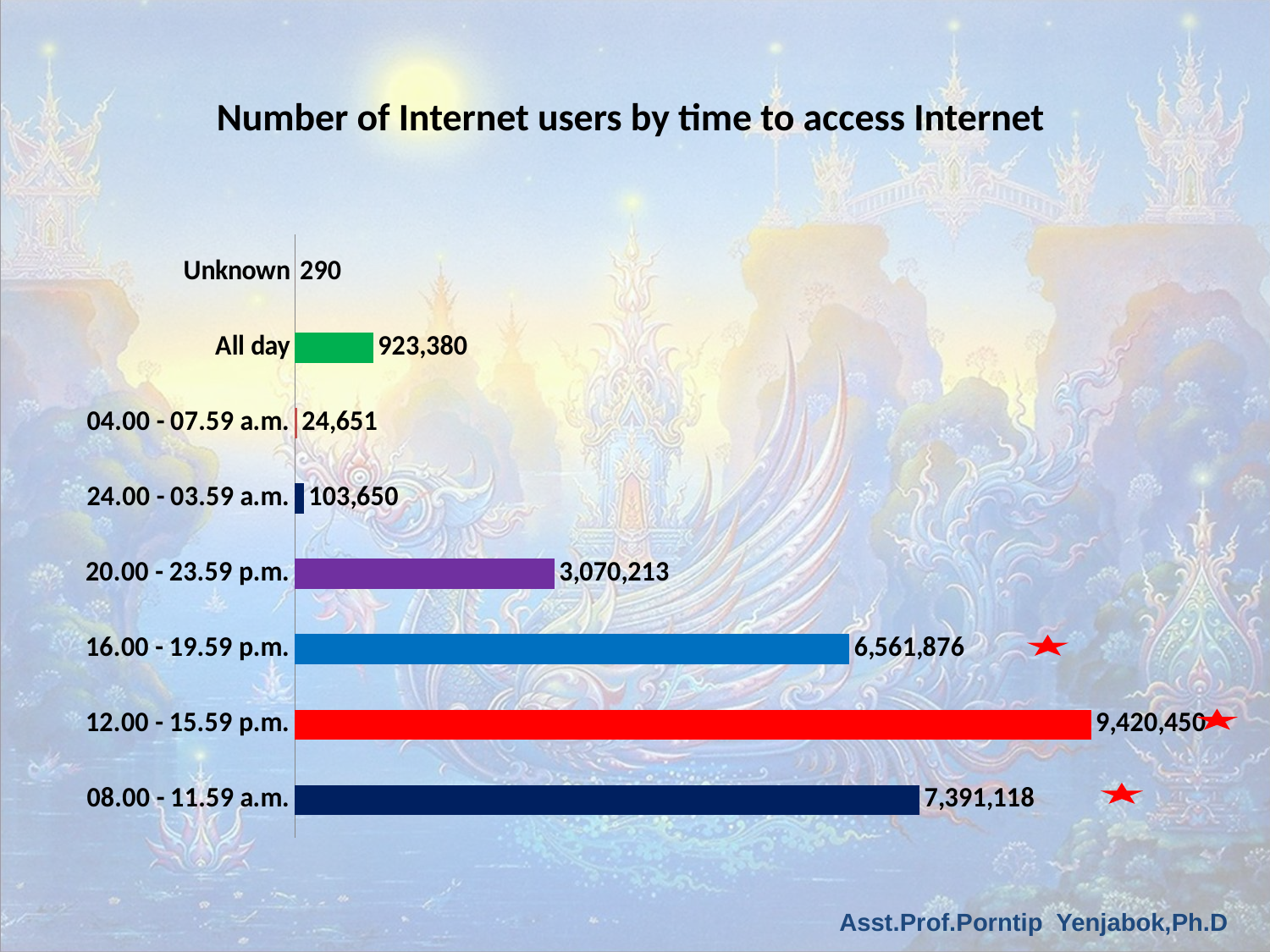
Which has more Internet users, 24.00 - 03.59 a.m. or 04.00 - 07.59 a.m.? 24.00 - 03.59 a.m. What is the number of Internet users for 12.00 - 15.59 p.m.? 9,420,450 What is the difference in Internet users between 12.00 - 15.59 p.m. and 08.00 - 11.59 a.m.? 2,029,332 What is the difference in Internet users between 08.00 - 11.59 a.m. and 16.00 - 19.59 p.m.? 829,242 What is the number of Internet users for 08.00 - 11.59 a.m.? 7,391,118 What is the title of the chart? Number of Internet users by time to access Internet How many categories are shown in the chart? 8 What is the number of Internet users for 20.00 - 23.59 p.m.? 3,070,213 What type of chart is shown on the slide? Bar chart Which category has the lowest number of Internet users? Unknown What is the number of Internet users for the All day category? 923,380 Which time period has the highest number of Internet users? 12.00 - 15.59 p.m.